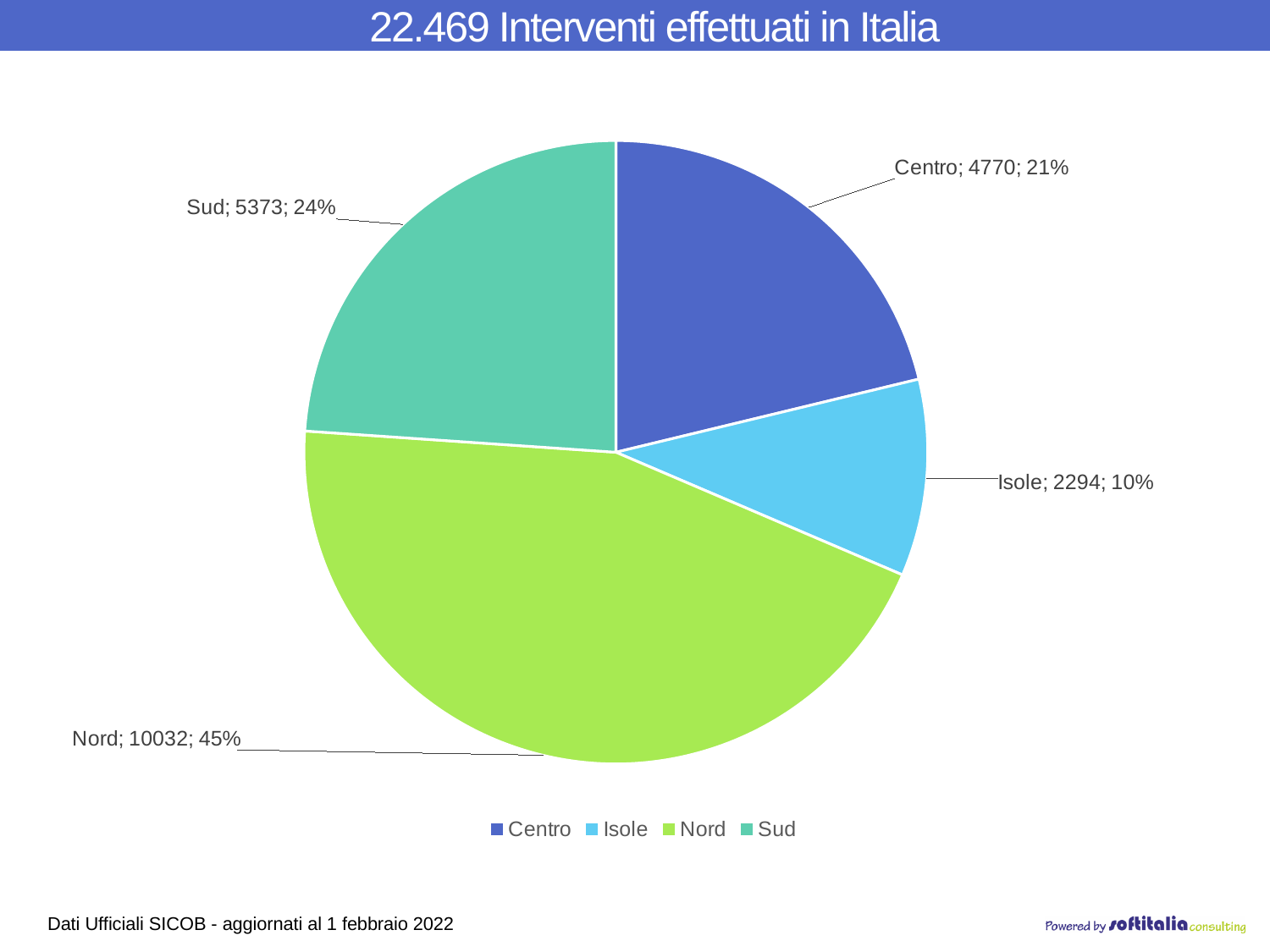
What percentage share does Centro have? 21% What percentage share does Sud have? 24% What is the title of the chart? 22.469 Interventi effettuati in Italia How many entries does the legend list? 4 Which region has the largest slice? Nord What kind of chart is shown on the slide? pie chart Which is larger, the value for Centro or the value for Isole? Centro What is the difference between the values for Sud and Centro? 603 What is the value for Isole? 2294 Which region has the smallest slice? Isole How many slices does the pie chart have? 4 How many interventions were carried out in Nord? 10032